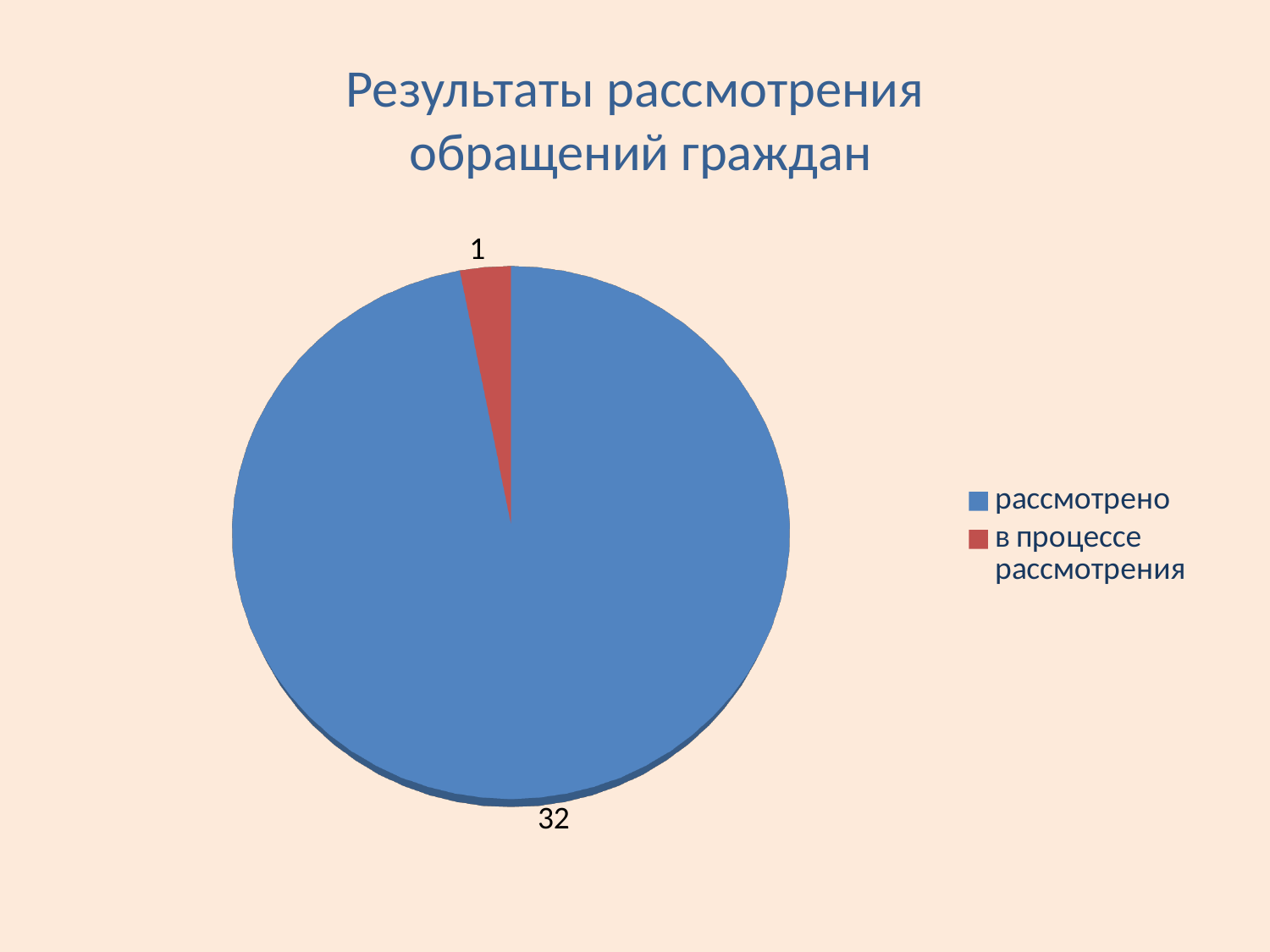
What is the value for the "в процессе рассмотрения" slice? 1 What colour is the "в процессе рассмотрения" slice? red What kind of chart is shown on the slide? pie chart How many slices does the pie chart have? 2 Which is larger: the value for "рассмотрено" or the value for "в процессе рассмотрения"? рассмотрено How many entries does the legend list? 2 Which category has the smallest slice of the pie? в процессе рассмотрения What is the value for the "рассмотрено" slice? 32 What is the total of all slices in the pie chart? 33 Which category has the largest slice of the pie? рассмотрено What is the difference between the values for "рассмотрено" and "в процессе рассмотрения"? 31 What is the title of the chart? Результаты рассмотрения обращений граждан